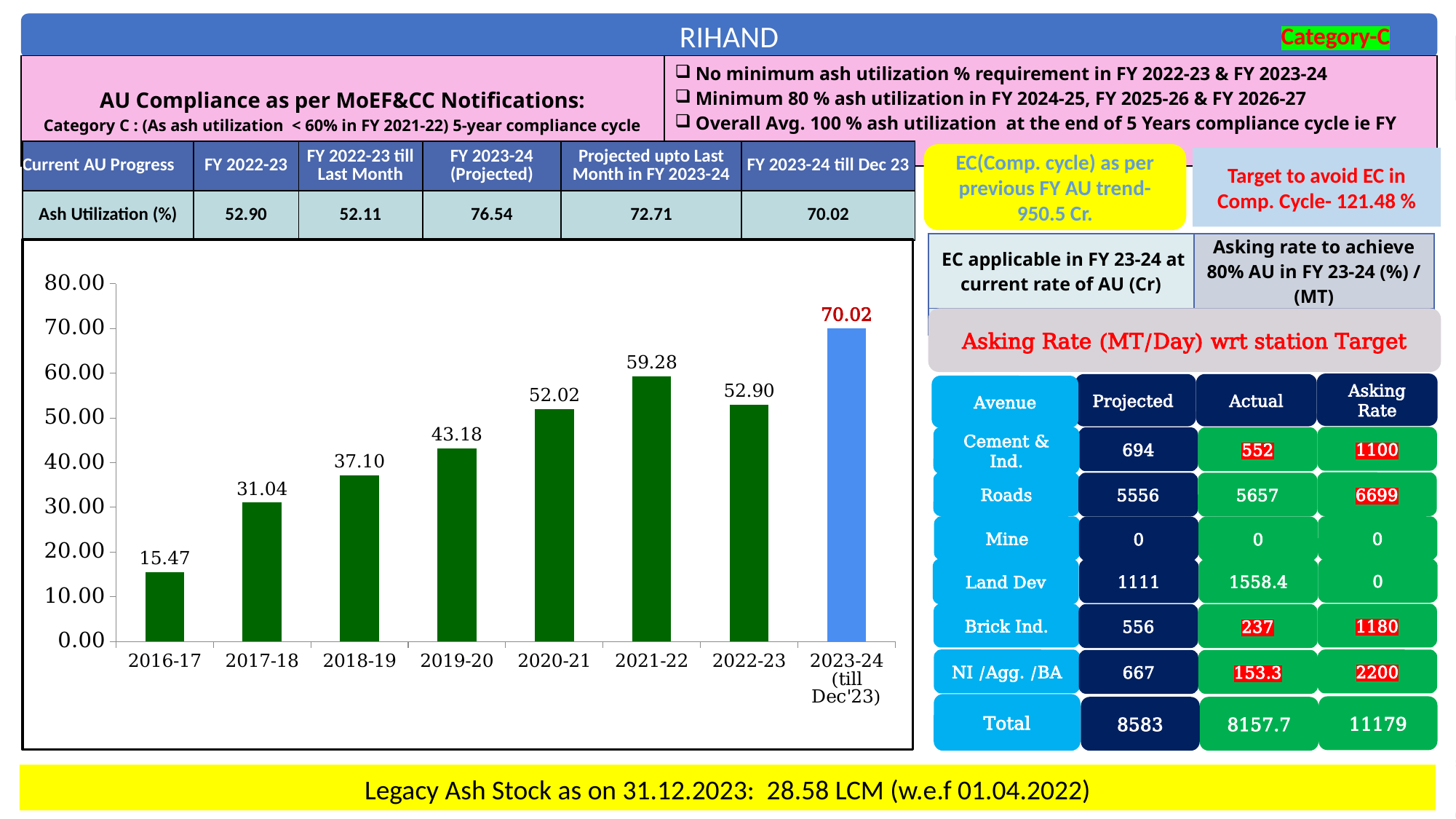
Which bar in the chart is coloured differently (blue) from the others? 2023-24 (till Dec'23) Which year has the lowest bar in the chart? 2016-17 What is the value plotted for 2019-20 in the bar chart? 43.18 What is the difference between the values for 2021-22 and 2022-23 in the bar chart? 6.38 Which is larger in the bar chart, the value for 2020-21 or the value for 2022-23? 2022-23 What kind of chart is shown on the slide? bar chart What is the value plotted for 2016-17 in the bar chart? 15.47 What is the value plotted for 2021-22 in the bar chart? 59.28 How many years (bars) are shown in the bar chart? 8 What is the value plotted for 2023-24 (till Dec'23) in the bar chart? 70.02 Which year has the highest bar in the chart? 2023-24 (till Dec'23) Is the value for 2018-19 in the bar chart greater or less than 40.00? less